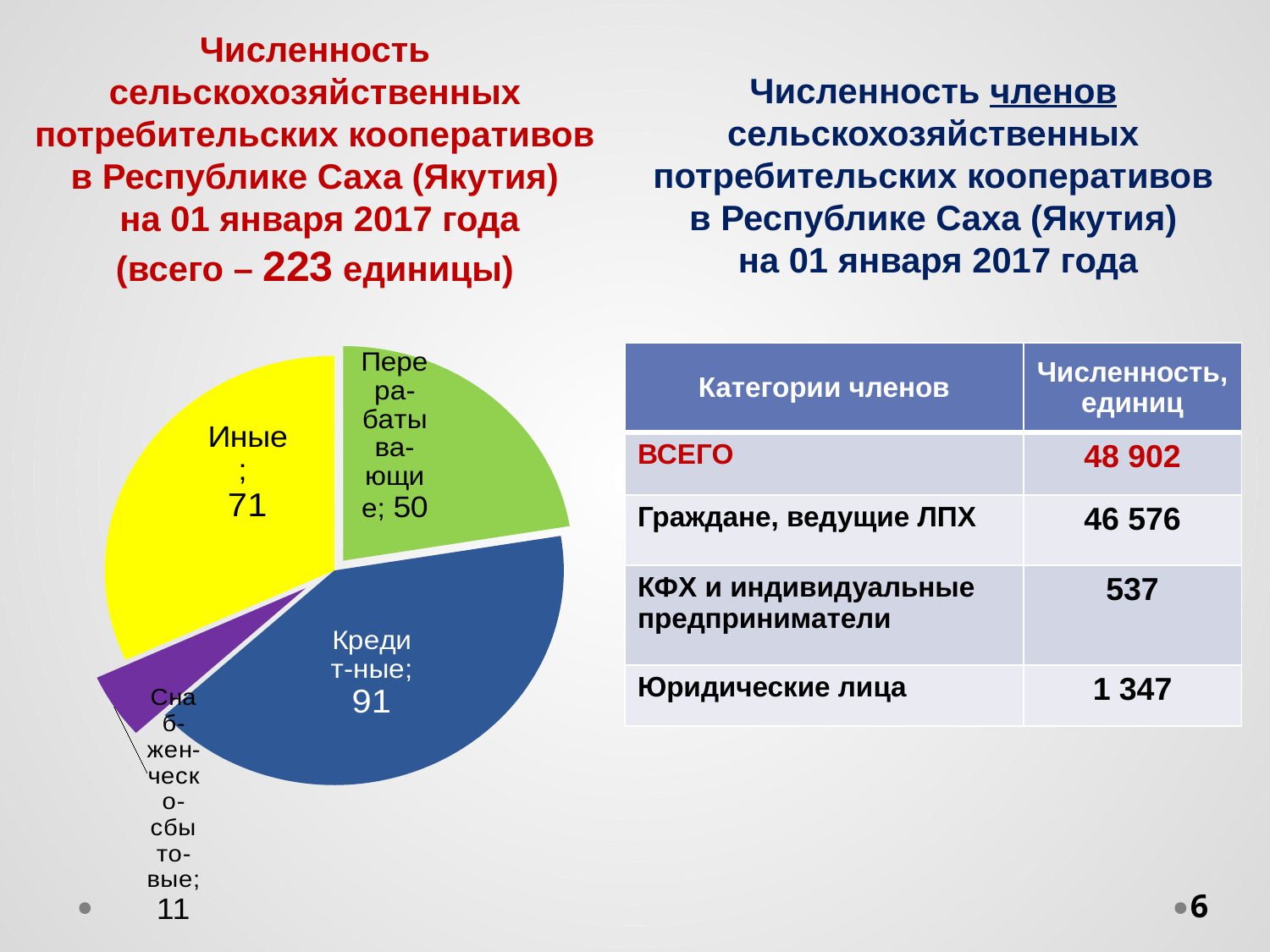
What type of chart is shown on the slide? pie chart What is the difference between the Перерабатывающие and Снабженческо-сбытовые values in the pie chart? 39 Which category has the largest slice in the pie chart? Кредитные What is the value for the Перерабатывающие slice of the pie chart? 50 What is the value for the Кредитные slice of the pie chart? 91 How many slices does the pie chart have? 4 What is the difference between the Кредитные and Иные values in the pie chart? 20 Which is larger in the pie chart: Иные or Перерабатывающие? Иные Which category has the smallest slice in the pie chart? Снабженческо-сбытовые What colour is the Кредитные slice of the pie chart? blue What is the value for the Иные slice of the pie chart? 71 What is the value for the Снабженческо-сбытовые slice of the pie chart? 11